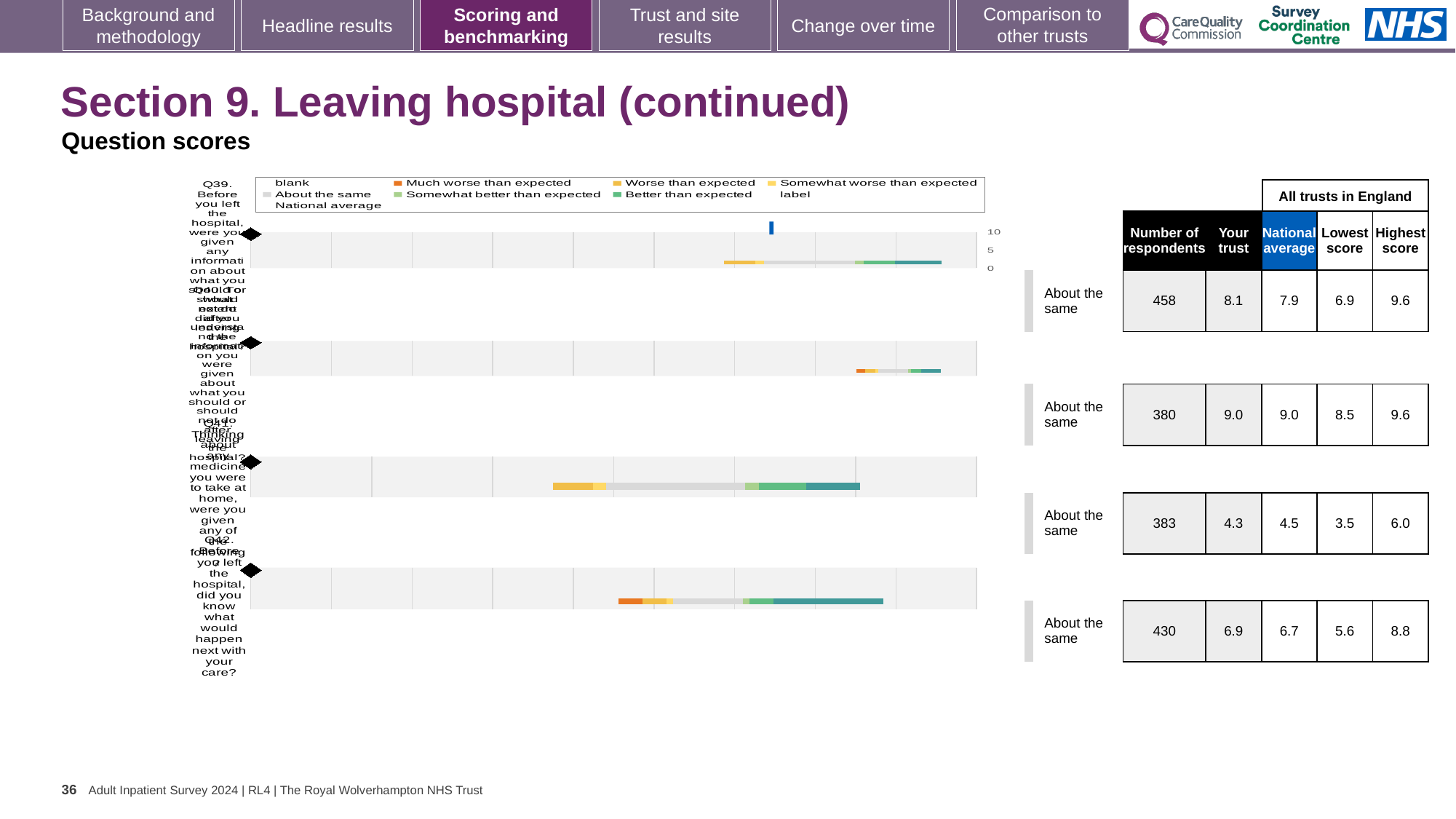
How many question charts are shown on the slide? 4 For the second chart (Q40), how many respondents are shown in the table? 380 For the top chart (Q39), what is the 'Your trust' score shown in the table? 8.1 What benchmark category is shown next to the bottom chart (Q42)? About the same For the third chart (Q41), which is larger: the 'Your trust' score or the national average? National average Which of the four questions has the highest 'Your trust' score? Q40 For the top chart (Q39), what is the difference between the highest score and the lowest score across all trusts in England? 2.7 In the chart legend, what colour represents 'Much worse than expected'? orange What kind of chart is used to show the benchmark ranges for each question on this slide? bar chart In the chart legend, what colour represents 'Better than expected'? teal For the bottom chart (Q42), what is the national average score shown in the table? 6.7 Which of the four questions has the lowest 'Your trust' score? Q41